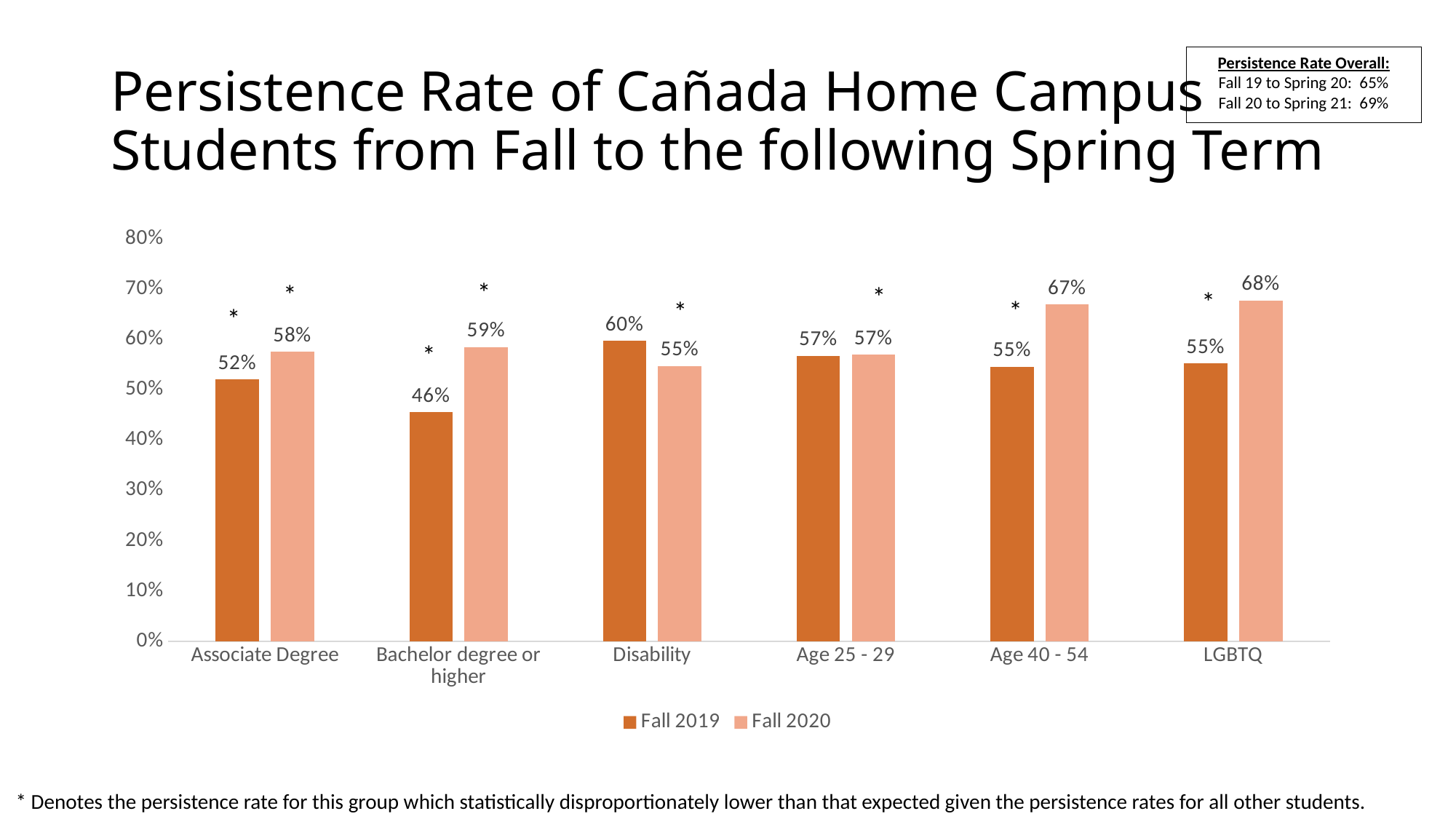
How many categories are shown on the x axis of the chart? 6 Which category has the highest Fall 2019 persistence rate? Disability For the Disability group, which is larger: the Fall 2019 or the Fall 2020 persistence rate? Fall 2019 Which category has the lowest Fall 2019 persistence rate? Bachelor degree or higher What kind of chart is shown on the slide? Bar chart How many series does the legend list? 2 What is the Fall 2020 persistence rate for Age 40 - 54 students? 67% What is the Fall 2019 persistence rate for Bachelor degree or higher students? 46% Which category has the highest Fall 2020 persistence rate? LGBTQ What is the difference between the Fall 2020 and Fall 2019 persistence rates for Bachelor degree or higher students? 13% What is the Fall 2019 persistence rate for Associate Degree students? 52% What is the Fall 2020 persistence rate for LGBTQ students? 68%